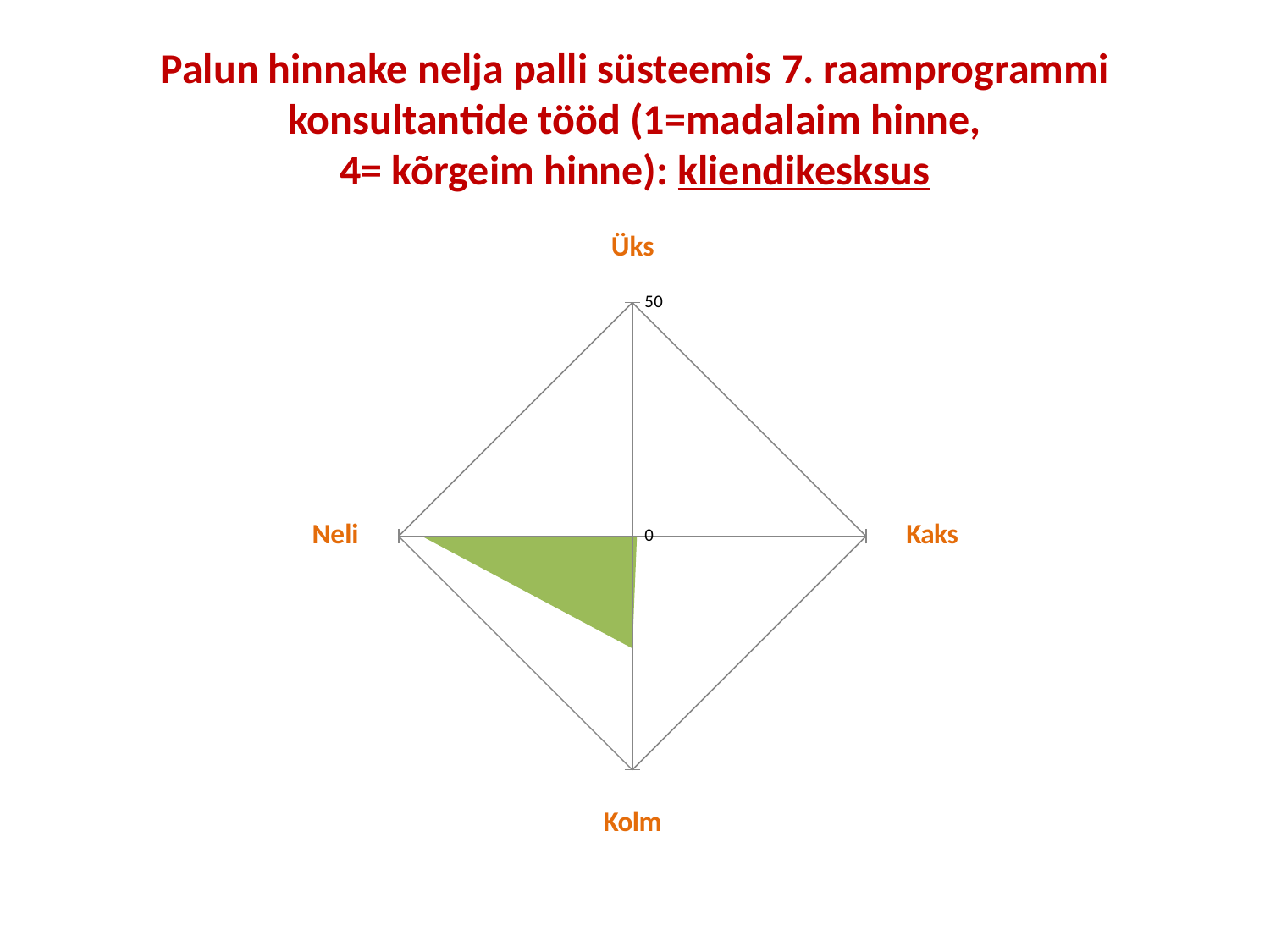
Which is larger, the value for Neli or the value for Üks? Neli Which is larger, the value for Kolm or the value for Kaks? Kolm What kind of chart is shown on the slide? radar chart How many categories does the radar chart have? 4 Which category has the highest value in the radar chart? Neli Is the value for Kolm greater or less than 50? less Which category label appears at the top of the radar chart? Üks What is the maximum value shown on the radar chart's axis? 50 Which is larger, the value for Neli or the value for Kolm? Neli